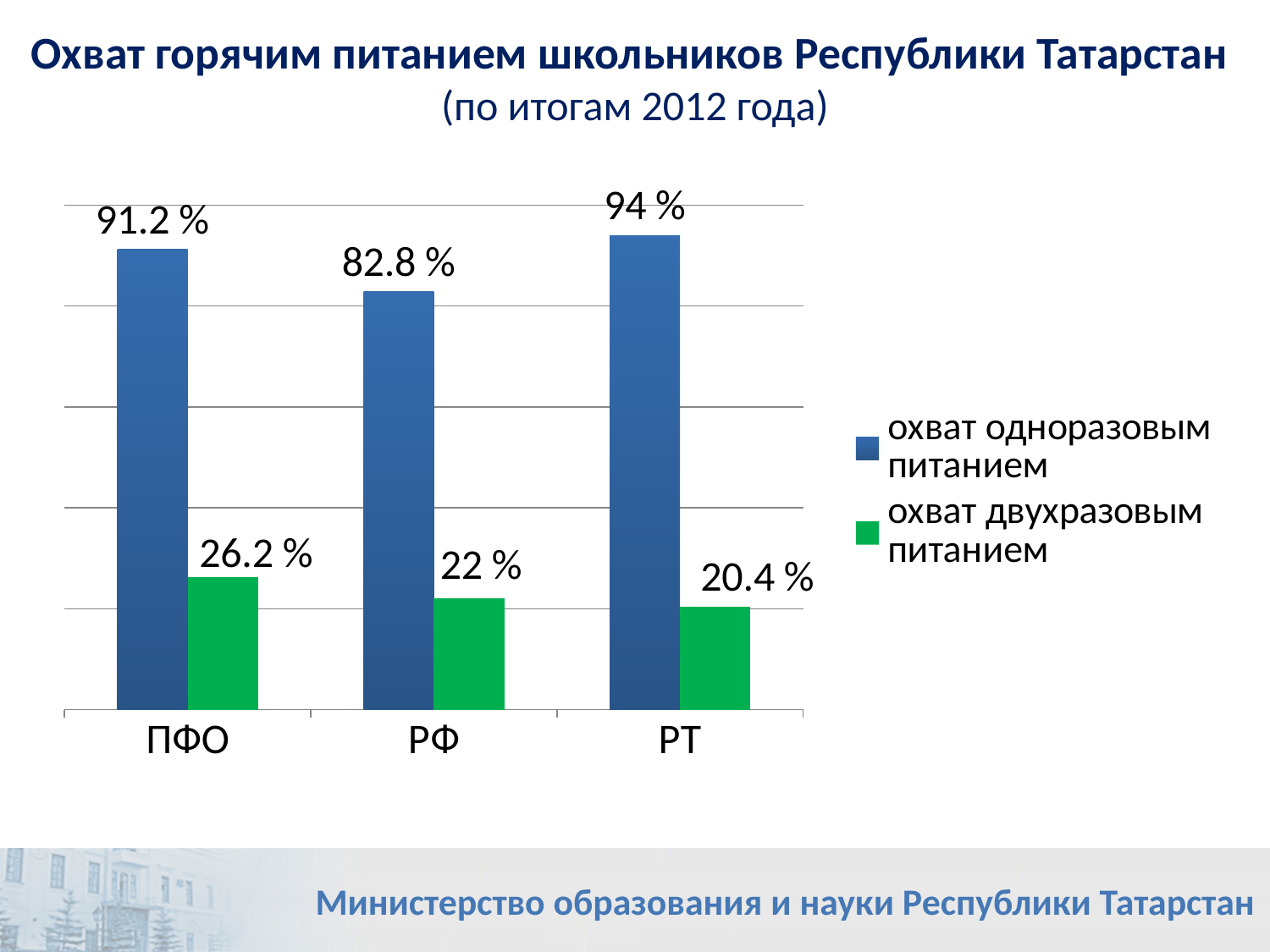
What is the value for ПФО in the 'охват одноразовым питанием' series? 91.2 % What is the difference between the 'охват одноразовым питанием' values for РТ and РФ? 11.2 % What is the value for РФ in the 'охват одноразовым питанием' series? 82.8 % What kind of chart is shown on the slide? bar chart Which is larger: the 'охват двухразовым питанием' value for ПФО or for РТ? ПФО Which colour represents the 'охват двухразовым питанием' series? green How many series does the legend list? 2 What is the value for РТ in the 'охват двухразовым питанием' series? 20.4 % Which category has the highest value for 'охват одноразовым питанием'? РТ What is the difference between the 'охват двухразовым питанием' values for ПФО and РФ? 4.2 % Which category has the lowest value for 'охват двухразовым питанием'? РТ How many categories are shown on the x axis? 3